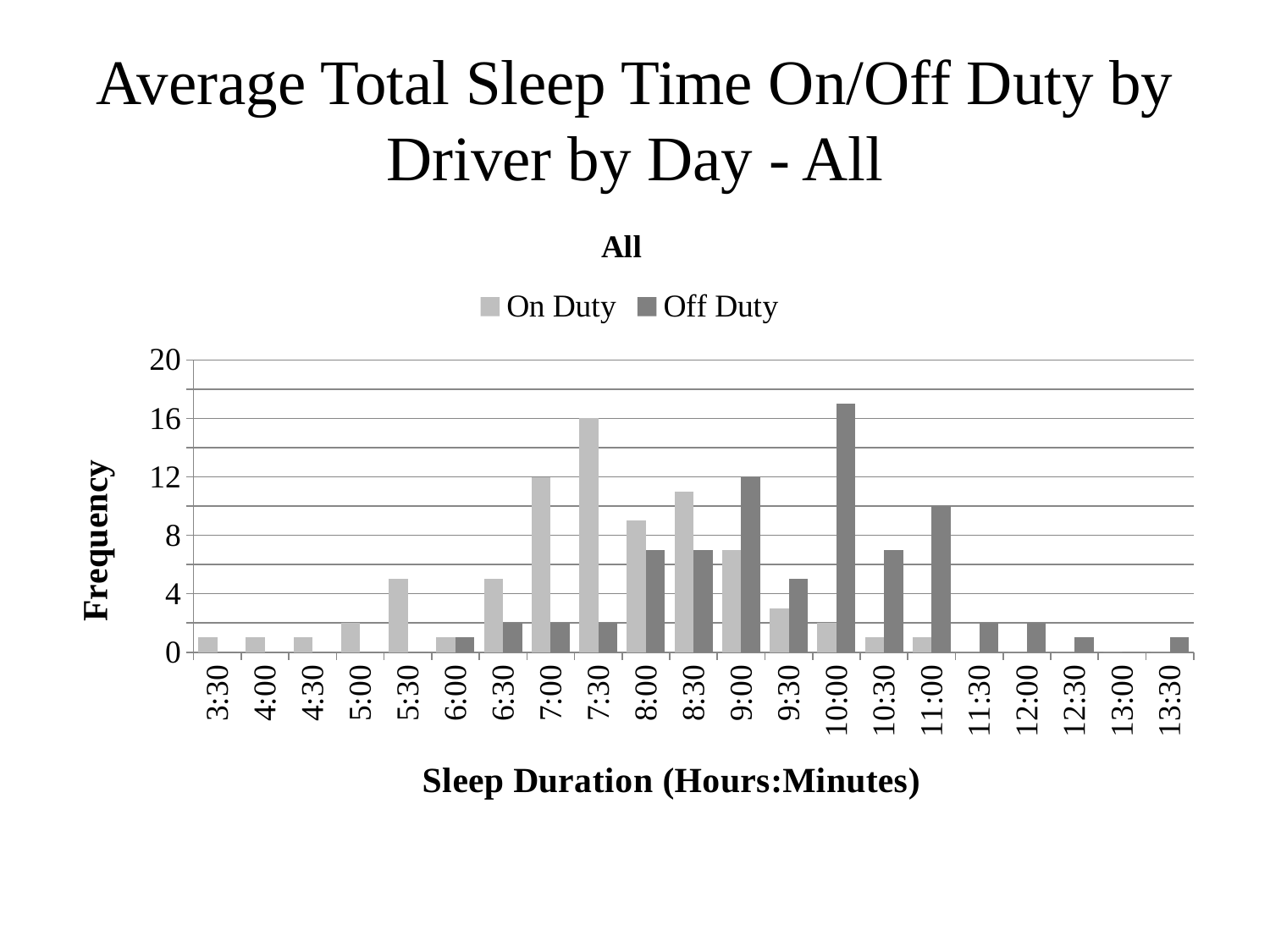
At a sleep duration of 8:00, which series has the larger frequency, On Duty or Off Duty? On Duty What is the title of the vertical axis? Frequency How many series does the legend list? 2 At a sleep duration of 9:00, which series has the larger frequency, On Duty or Off Duty? Off Duty Is the On Duty frequency for 8:30 greater or less than 8? greater Which sleep duration has the highest On Duty frequency? 7:30 What is the On Duty frequency for a sleep duration of 7:30? 16 How many sleep duration categories are shown on the x axis? 21 Is the Off Duty frequency for 10:00 greater or less than 16? greater Which sleep duration has the highest Off Duty frequency? 10:00 What type of chart is shown on the slide? bar chart What is the Off Duty frequency for a sleep duration of 9:00? 12